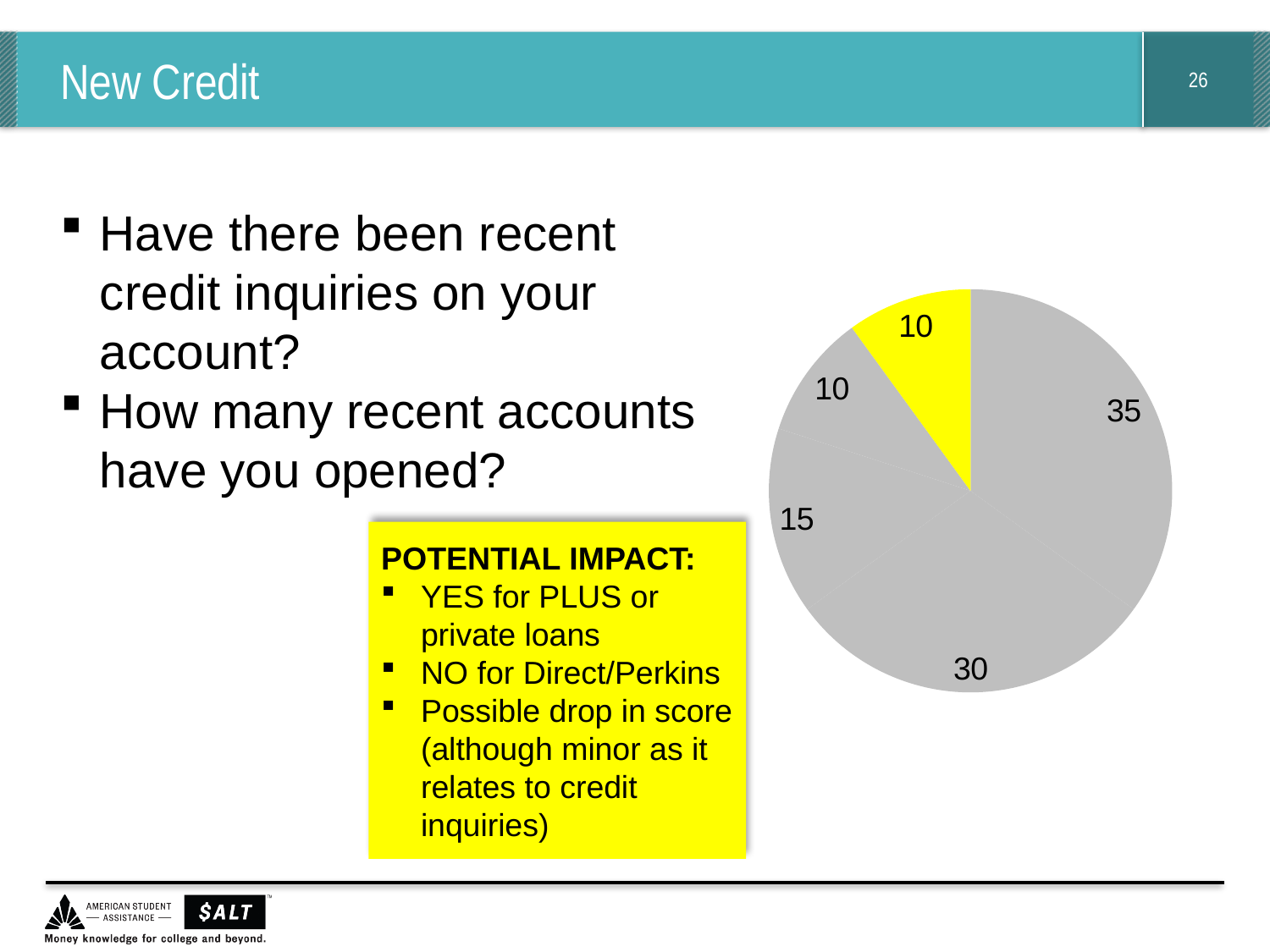
How many slices does the pie chart have? 5 What colour is the slice labelled 10 at the top of the pie chart? yellow What is the difference between the largest slice (35) and the second largest slice (30)? 5 What share of the pie does the yellow slice represent? 10% Which is larger, the slice labelled 15 or the yellow slice? the slice labelled 15 What is the total of all the slice values in the pie chart? 100 What is the value of the smallest slice in the pie chart? 10 What kind of chart is shown on the slide? pie chart What is the value of the largest slice in the pie chart? 35 What is the difference between the slice labelled 30 and the slice labelled 15? 15 What share of the pie does the largest slice (35) represent? 35% What is the value of the yellow slice in the pie chart? 10